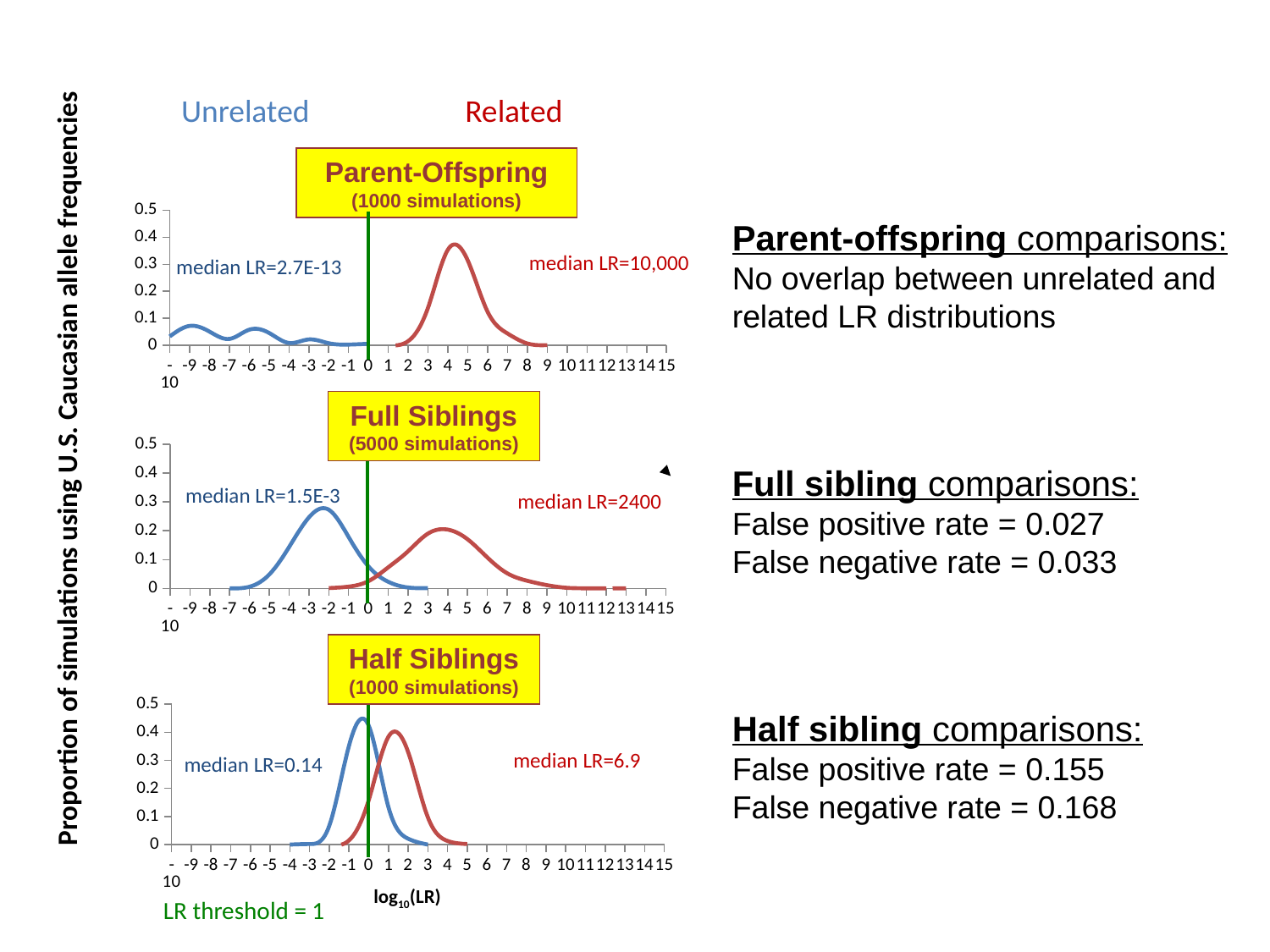
In the Parent-Offspring chart, is the peak of the Related curve greater or less than 0.3? greater In the Half Siblings chart, what is the median LR printed for the Related distribution? 6.9 In the Full Siblings chart, what is the median LR printed for the Related distribution? 2400 What kind of chart is used for the Parent-Offspring (1000 simulations) plot? line chart How many curves (series) are plotted in the Full Siblings chart? 2 In the Parent-Offspring chart, what is the median LR printed for the Related distribution? 10,000 In the Half Siblings chart, what is the median LR printed for the Unrelated distribution? 0.14 In the Half Siblings chart, is the peak of the Unrelated curve greater or less than 0.4? greater How many charts are shown on the slide? 3 How many simulations does the Full Siblings chart title say were run? 5000 simulations In the Full Siblings chart, which curve reaches a higher peak, Unrelated or Related? Unrelated In the Parent-Offspring chart, what is the median LR printed for the Unrelated distribution? 2.7E-13